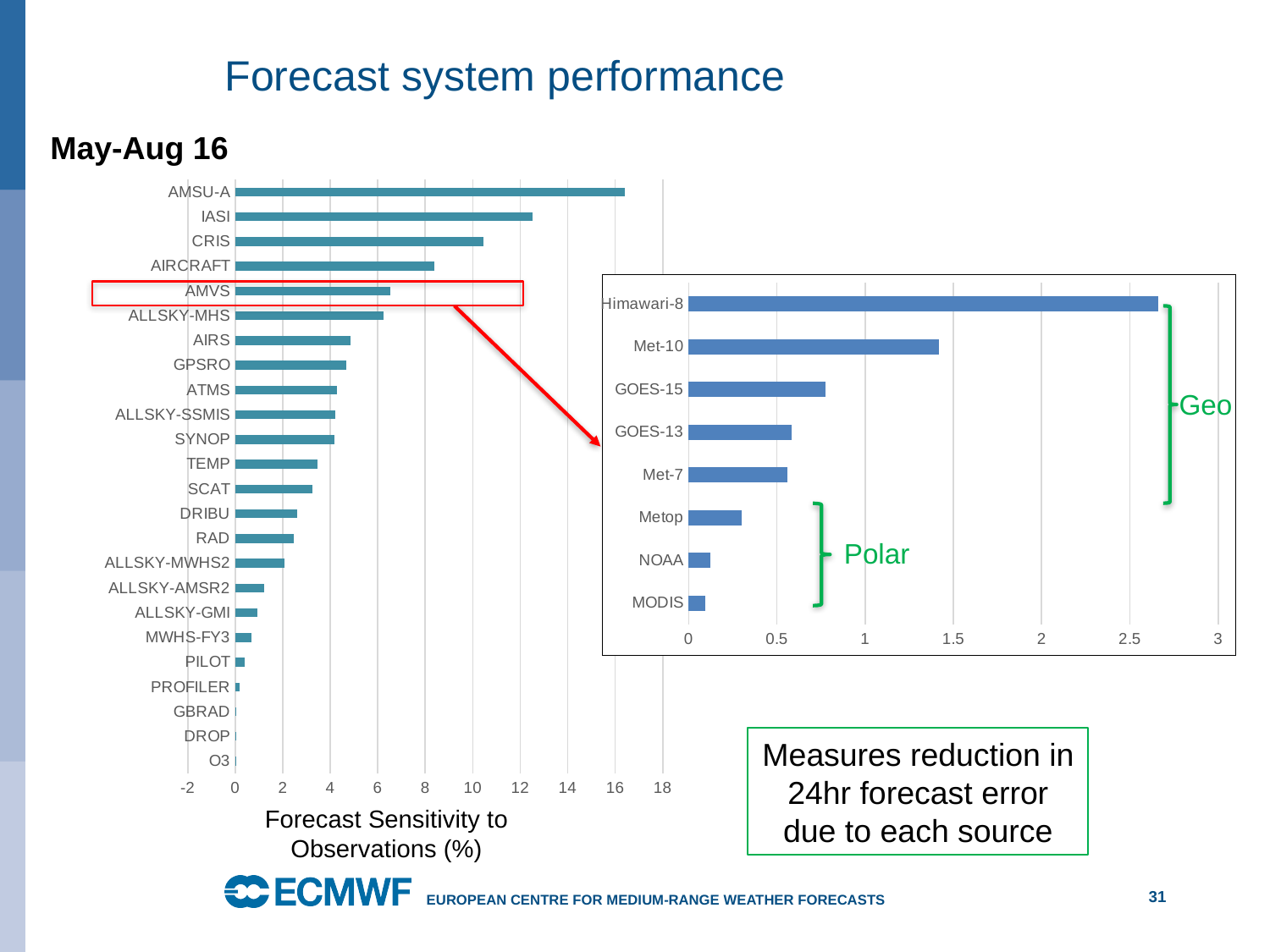
On the left chart (Forecast Sensitivity to Observations), what kind of chart is it? bar chart On the inset chart on the right (AMVS breakdown), which is larger, Met-10 or GOES-13? Met-10 On the left chart (Forecast Sensitivity to Observations), which category has the highest value? AMSU-A On the left chart (Forecast Sensitivity to Observations), is the value for AMSU-A greater or less than 14? greater On the inset chart on the right (AMVS breakdown), is the value for Himawari-8 greater or less than 2.5? greater On the inset chart on the right (AMVS breakdown), how many categories are plotted? 8 On the left chart, what is the x-axis title? Forecast Sensitivity to Observations (%) On the left chart (Forecast Sensitivity to Observations), how many categories are plotted? 24 On the left chart (Forecast Sensitivity to Observations), which is larger, IASI or CRIS? IASI On the left chart (Forecast Sensitivity to Observations), is the value for AMVS greater or less than 8? less On the inset chart on the right (AMVS breakdown), which category has the highest value? Himawari-8